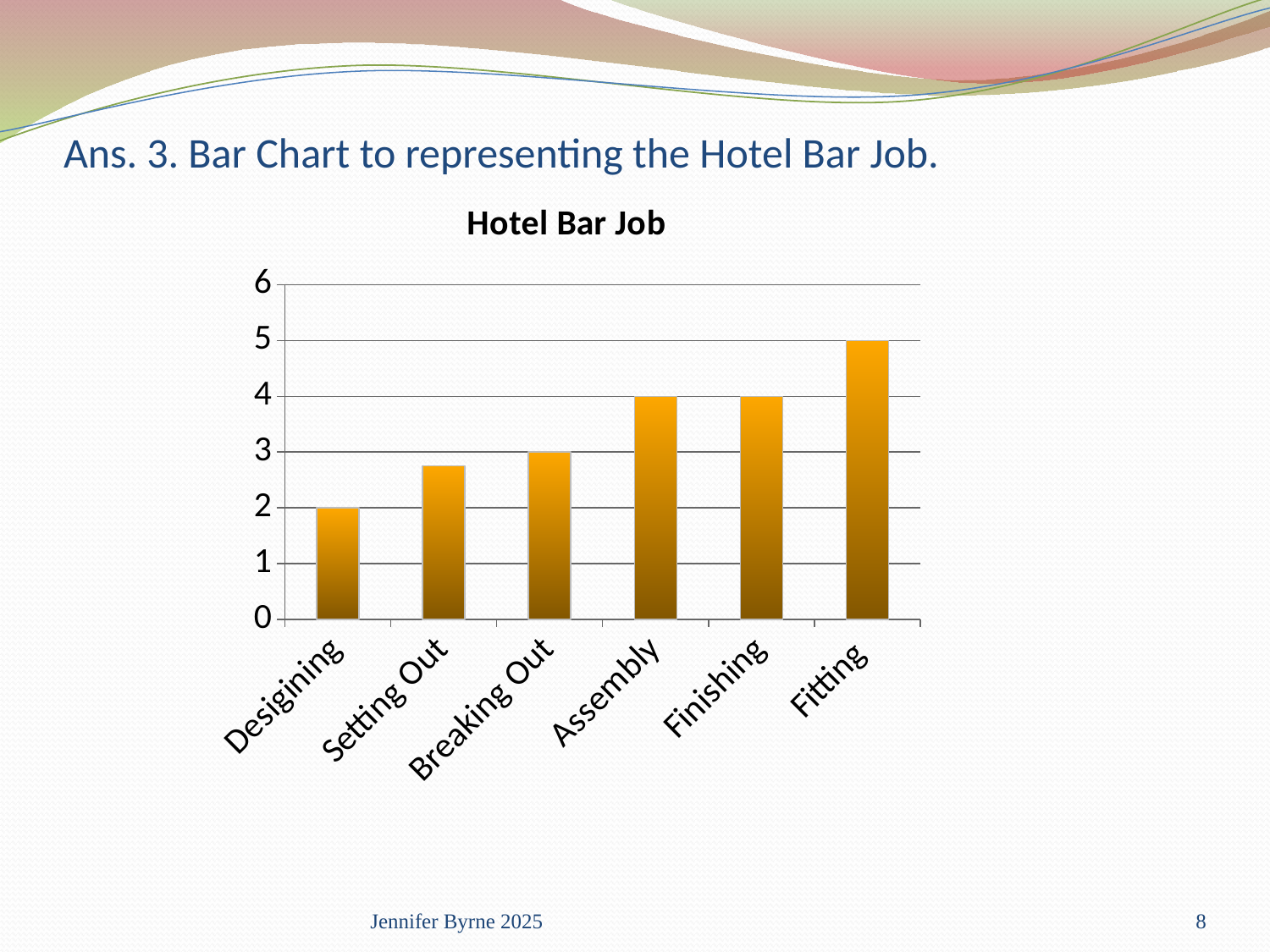
How many categories are shown on the x axis of the chart? 6 Do the values generally rise or fall from left to right along the x axis? Rise What is the difference between the values for Fitting and Desigining? 3 What type of chart is shown on the slide? Bar chart What is the value for Fitting? 5 Which category has the highest value? Fitting Is the value for Setting Out greater or less than 3? less What is the value for Breaking Out? 3 What is the title of the chart? Hotel Bar Job What is the value for Assembly? 4 Which category has the lowest value? Desigining What is the value for Desigining? 2